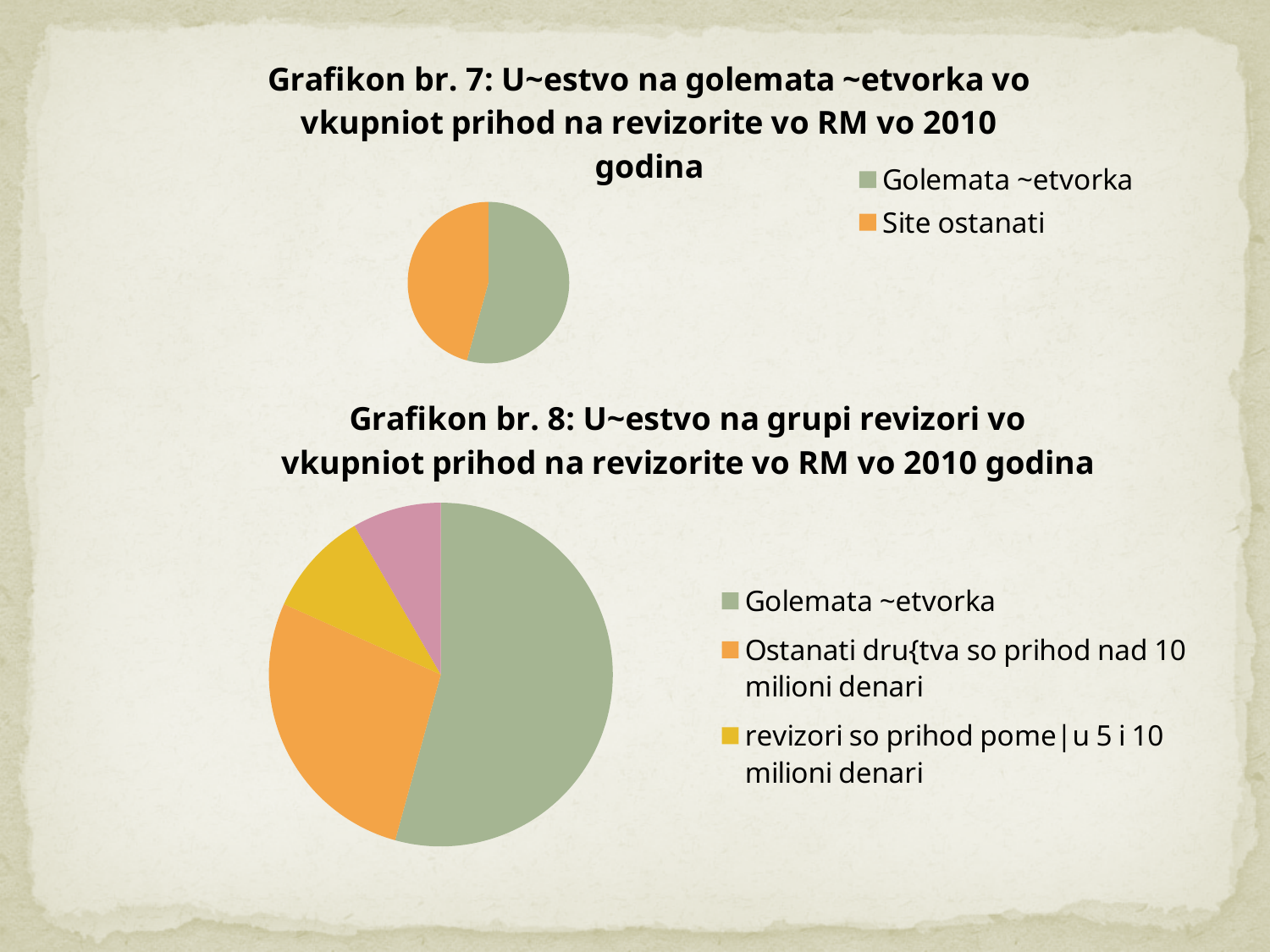
In Grafikon br. 8, which category has the largest slice? Golemata ~etvorka In Grafikon br. 7, what colour is the slice for Site ostanati? orange In Grafikon br. 8, what colour is the slice for revizori so prihod pome|u 5 i 10 milioni denari? yellow What kind of chart is Grafikon br. 7? pie chart How many slices does the pie in Grafikon br. 7 have? 2 In Grafikon br. 8, which slice is larger: Golemata ~etvorka or Ostanati dru{tva so prihod nad 10 milioni denari? Golemata ~etvorka What kind of chart is Grafikon br. 8? pie chart How many slices does the pie in Grafikon br. 8 have? 4 How many entries does the legend of Grafikon br. 7 list? 2 How many entries does the legend of Grafikon br. 8 list? 3 In Grafikon br. 8, which slice is larger: Ostanati dru{tva so prihod nad 10 milioni denari or revizori so prihod pome|u 5 i 10 milioni denari? Ostanati dru{tva so prihod nad 10 milioni denari